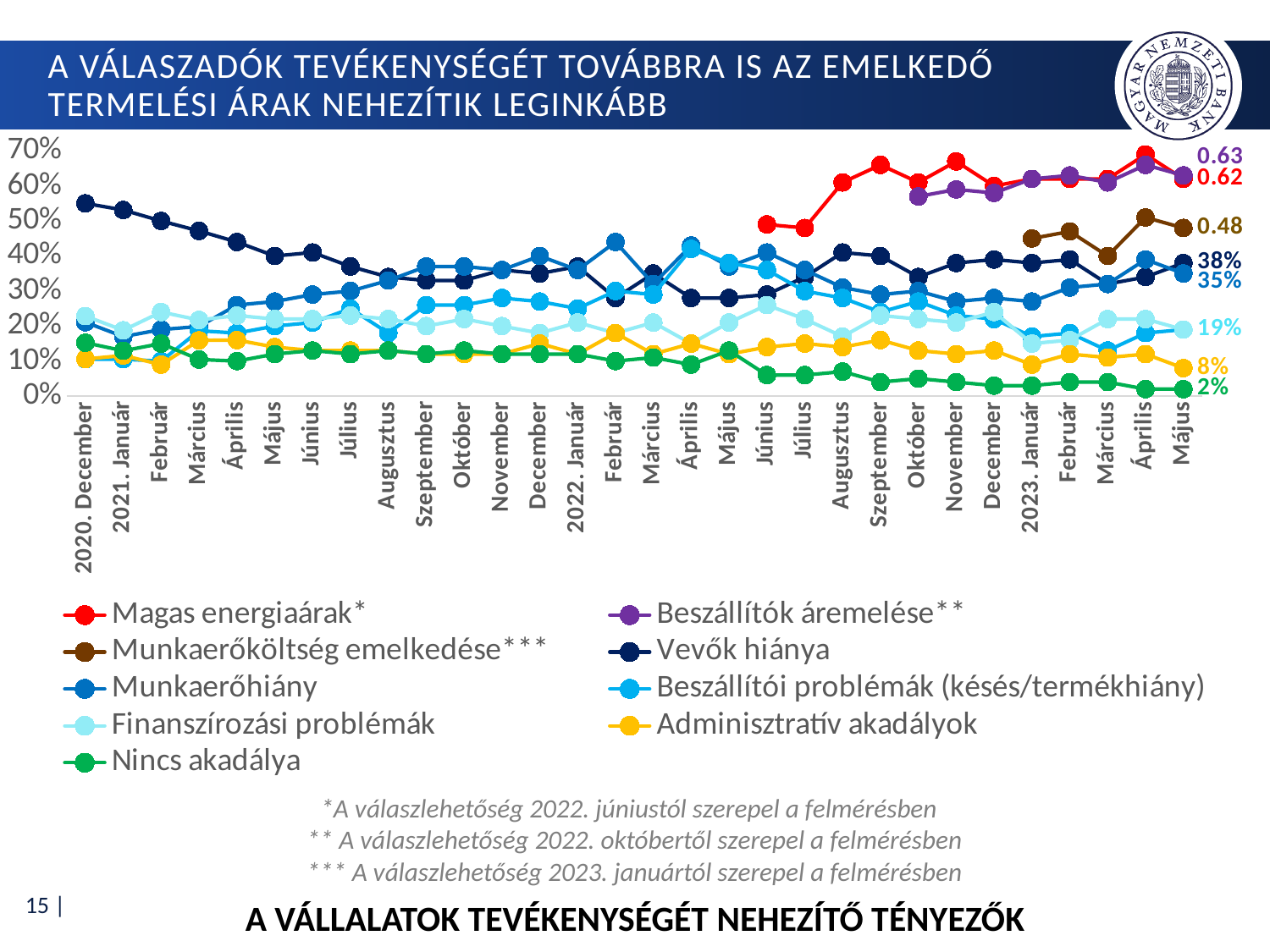
Which series has the highest value in 2023 Május? Beszállítók áremelése What is the value for Munkaerőköltség emelkedése in 2023 Május? 0.48 How many series does the legend list? 9 What kind of chart is shown on the slide? line chart What is the value for Nincs akadálya in 2023 Május? 2% Does the Vevők hiánya series rise or fall from 2020 December to 2023 Május? fall What is the value for Vevők hiánya in 2023 Május? 38% Is the value for Vevők hiánya in 2020 December greater or less than 50%? greater What is the value for Beszállítók áremelése in 2023 Május? 0.63 In 2023 Május, which is larger: Vevők hiánya or Munkaerőhiány? Vevők hiánya What is the value for Magas energiaárak in 2023 Május? 0.62 Which series has the lowest value in 2023 Május? Nincs akadálya